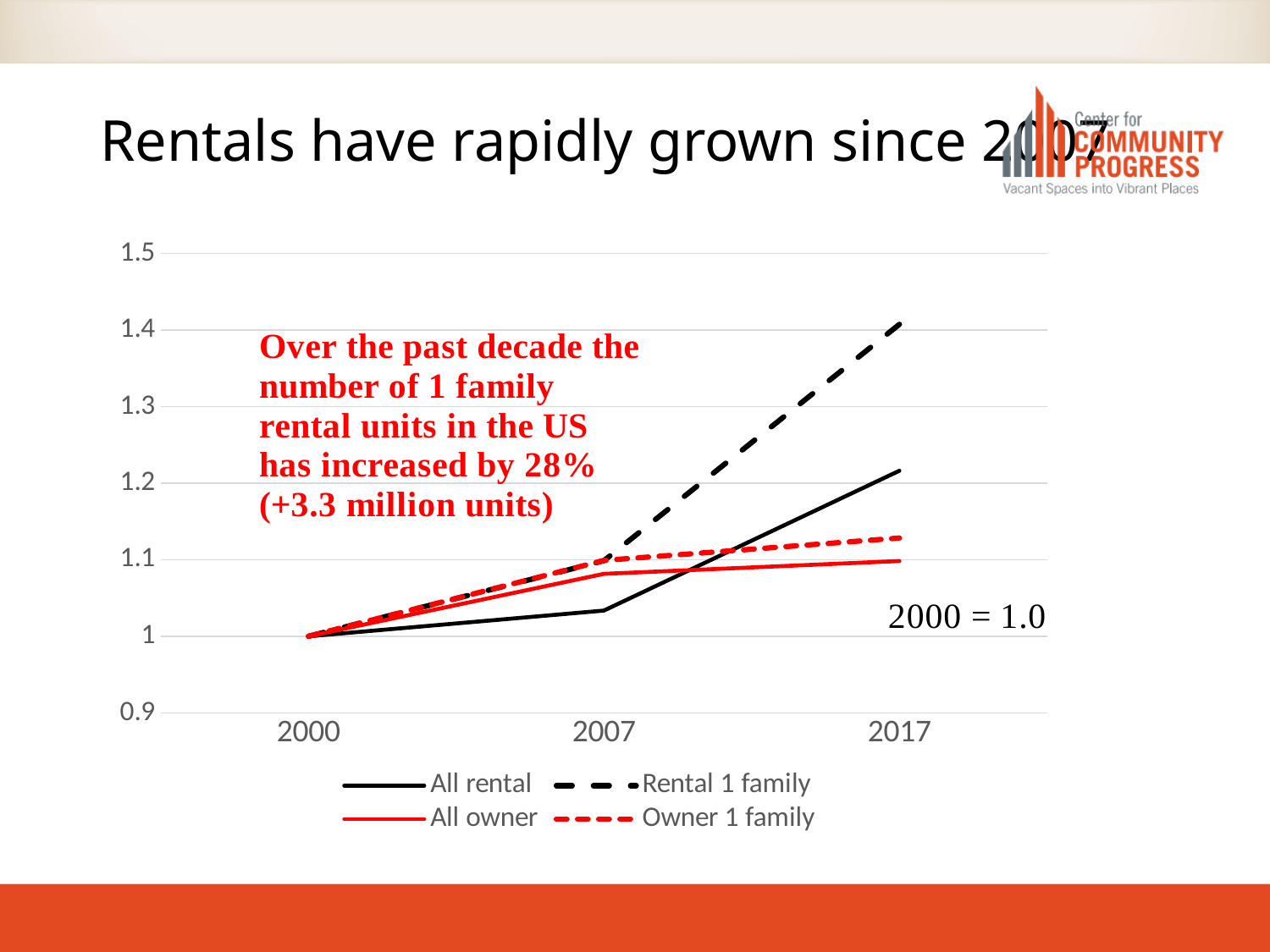
Does the Rental 1 family series rise or fall from 2000 to 2017? rise In 2017, which is larger: All rental or All owner? All rental How many series does the legend list? 4 Which series has the lowest value in 2017? All owner What kind of chart is shown on the slide? line chart Is the value for All rental in 2007 greater or less than 1.1? less What is the index value of the series in the base year 2000? 1.0 How many years are shown on the x axis? 3 In 2007, which is larger: All rental or All owner? All owner Which series has the highest value in 2017? Rental 1 family Is the value for Owner 1 family in 2017 greater or less than 1.2? less Is the value for Rental 1 family in 2017 greater or less than 1.3? greater